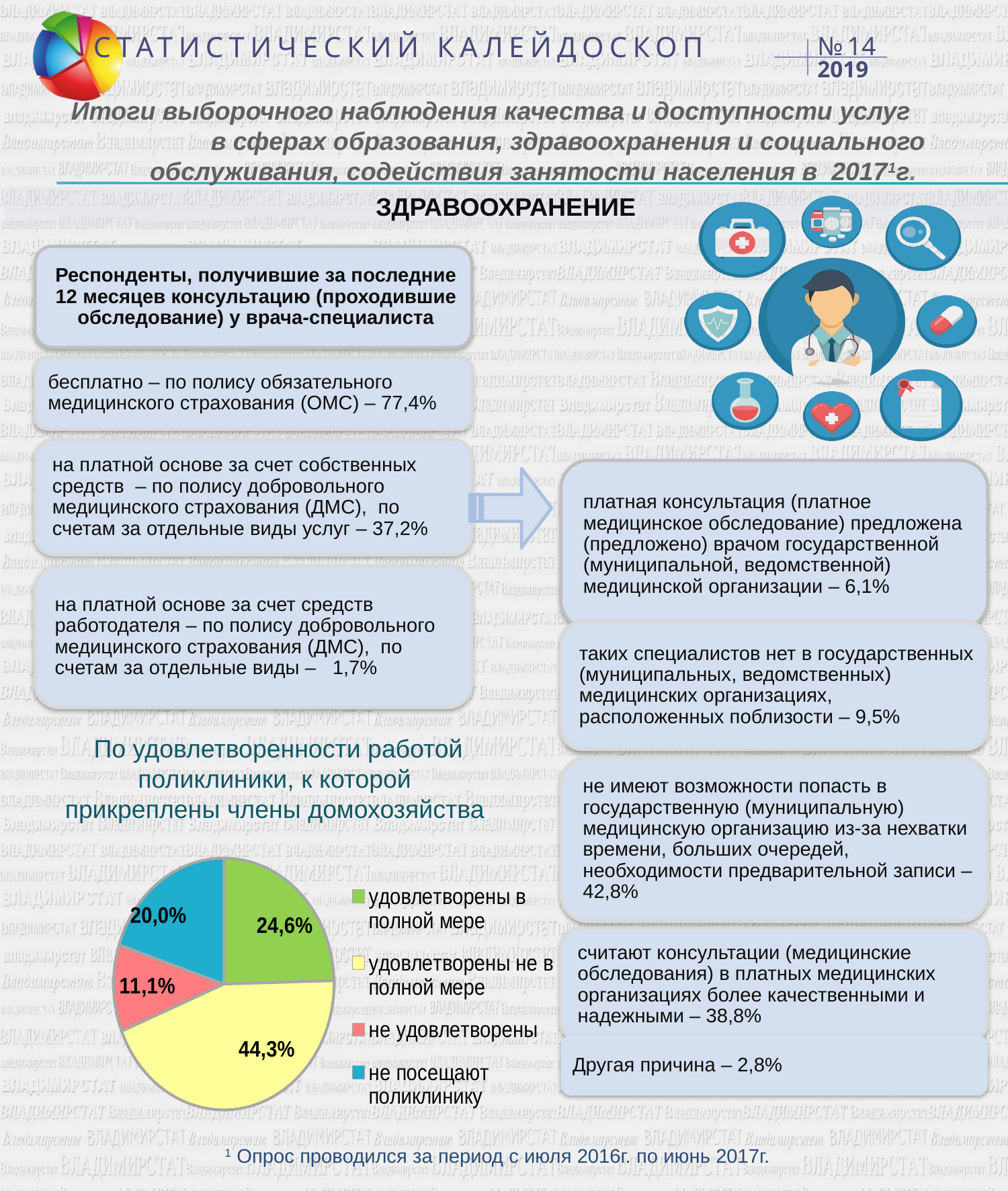
Which is larger: the share for 'не посещают поликлинику' or the share for 'не удовлетворены'? не посещают поликлинику What share of respondents are 'удовлетворены в полной мере' in the pie chart? 24,6% Which category has the largest slice in the pie chart? удовлетворены не в полной мере How many slices does the pie chart have? 4 Which category has the smallest slice in the pie chart? не удовлетворены What colour is the slice for 'не удовлетворены' in the pie chart? red What share of respondents 'не посещают поликлинику' according to the pie chart? 20,0% What type of chart is shown on the slide? pie chart What is the difference between the shares for 'не посещают поликлинику' and 'не удовлетворены'? 8,9% What share of respondents are 'не удовлетворены' in the pie chart? 11,1% What share of respondents are 'удовлетворены не в полной мере' in the pie chart? 44,3% What is the difference between the shares for 'удовлетворены не в полной мере' and 'удовлетворены в полной мере'? 19,7%